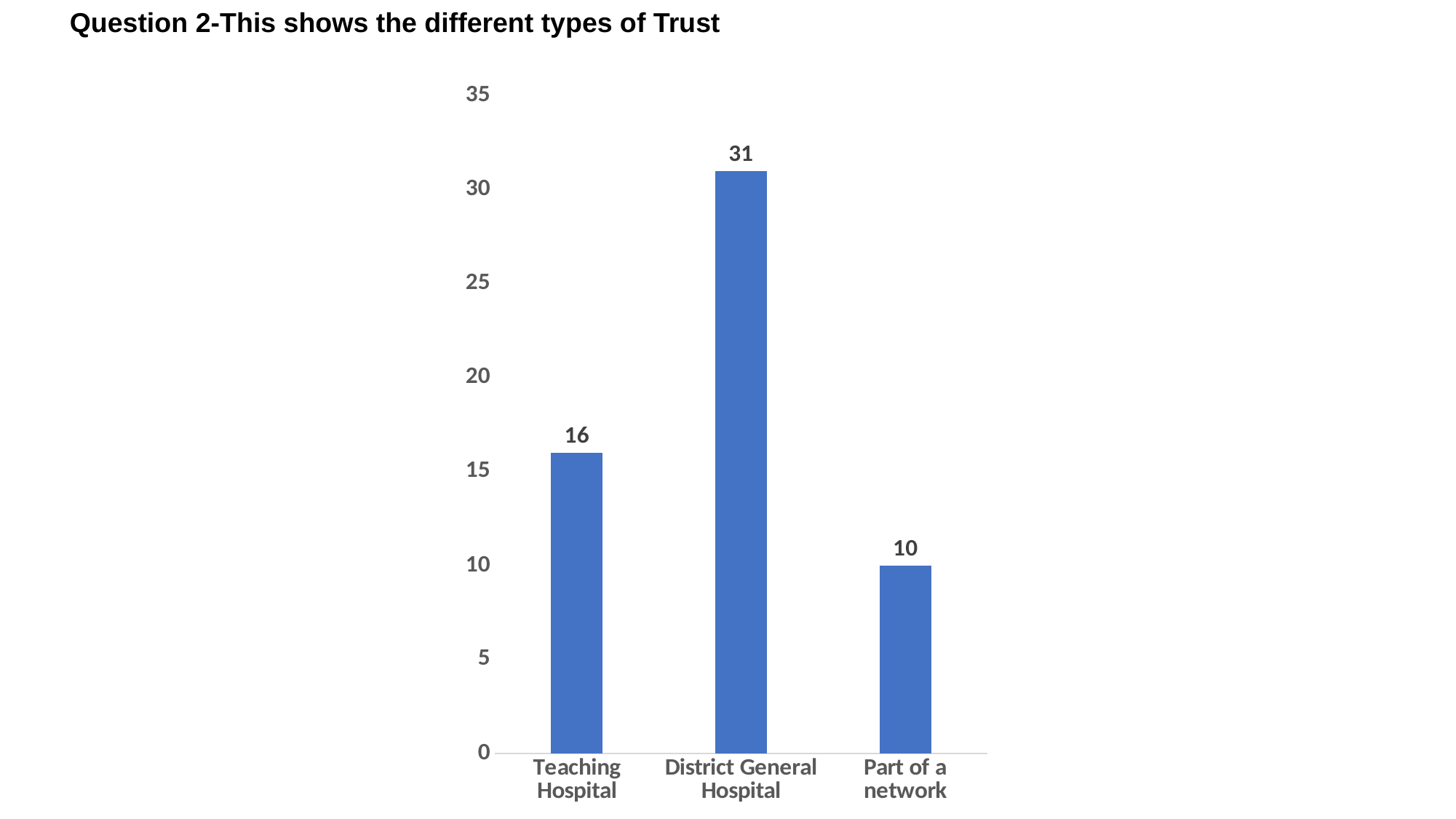
Which category has the lowest value? Part of a network Which is larger, the value for Teaching Hospital or the value for Part of a network? Teaching Hospital What is the value for District General Hospital? 31 What is the title of the slide? Question 2-This shows the different types of Trust What kind of chart is shown on the slide? bar chart Which category has the highest value? District General Hospital What is the value for Teaching Hospital? 16 Is the value for District General Hospital greater or less than 25? greater What is the value for Part of a network? 10 What is the difference between the values for Teaching Hospital and Part of a network? 6 How many categories are shown on the x axis? 3 What is the difference between the values for District General Hospital and Teaching Hospital? 15